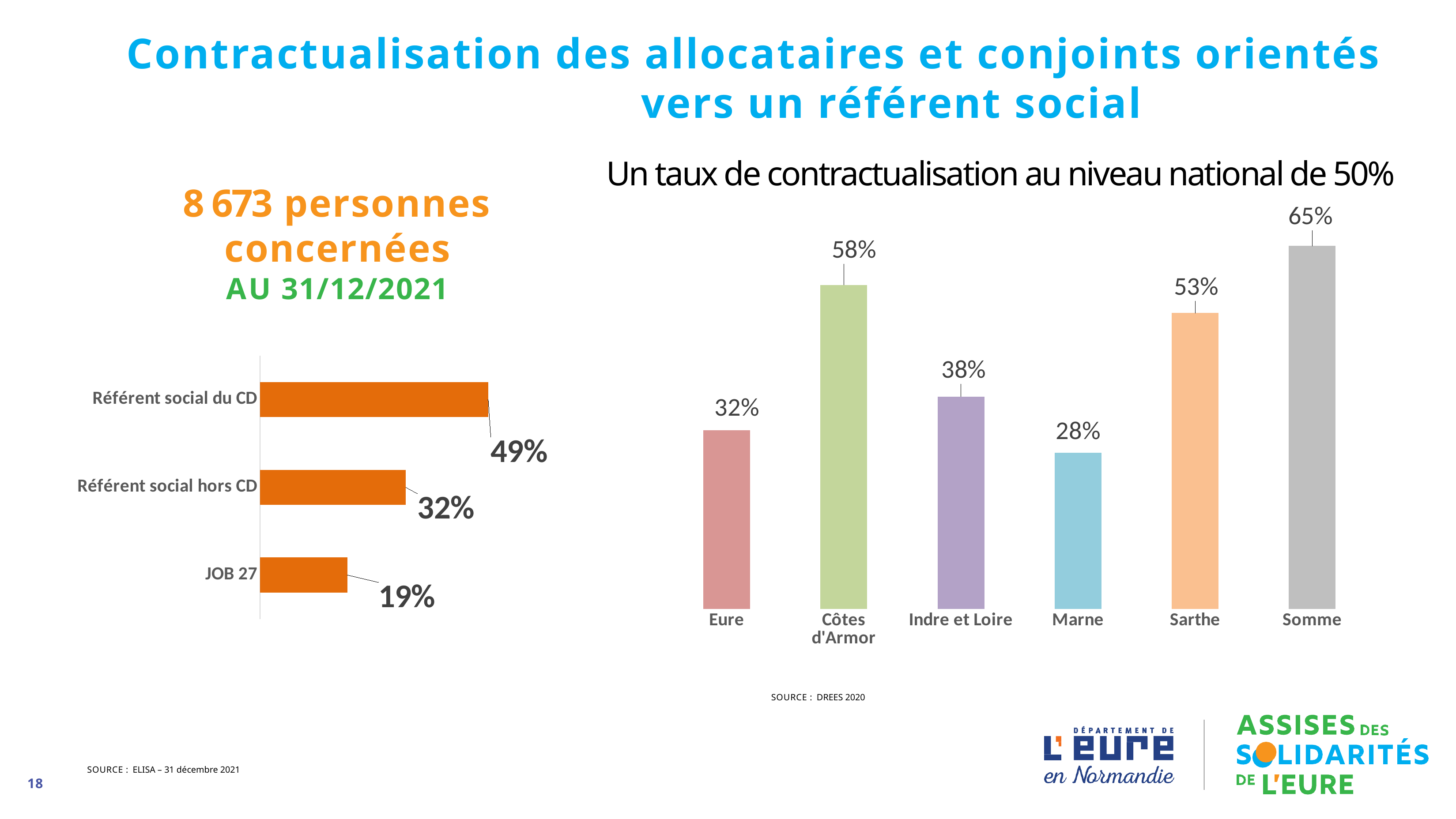
In the left chart, what is the difference between Référent social du CD and Référent social hors CD? 17% What kind of chart is the left chart? Bar chart In the right chart, what is the value for Marne? 28% In the right chart, which department has the lowest value? Marne In the left chart, what is the value for Référent social du CD? 49% In the right chart, what is the value for Sarthe? 53% In the right chart, what is the difference between Somme and Eure? 33% In the left chart, how many categories are shown? 3 In the left chart, which category has the lowest value? JOB 27 In the right chart, which is larger, Côtes d'Armor or Indre et Loire? Côtes d'Armor In the right chart, which department has the highest value? Somme In the left chart, what is the value for JOB 27? 19%